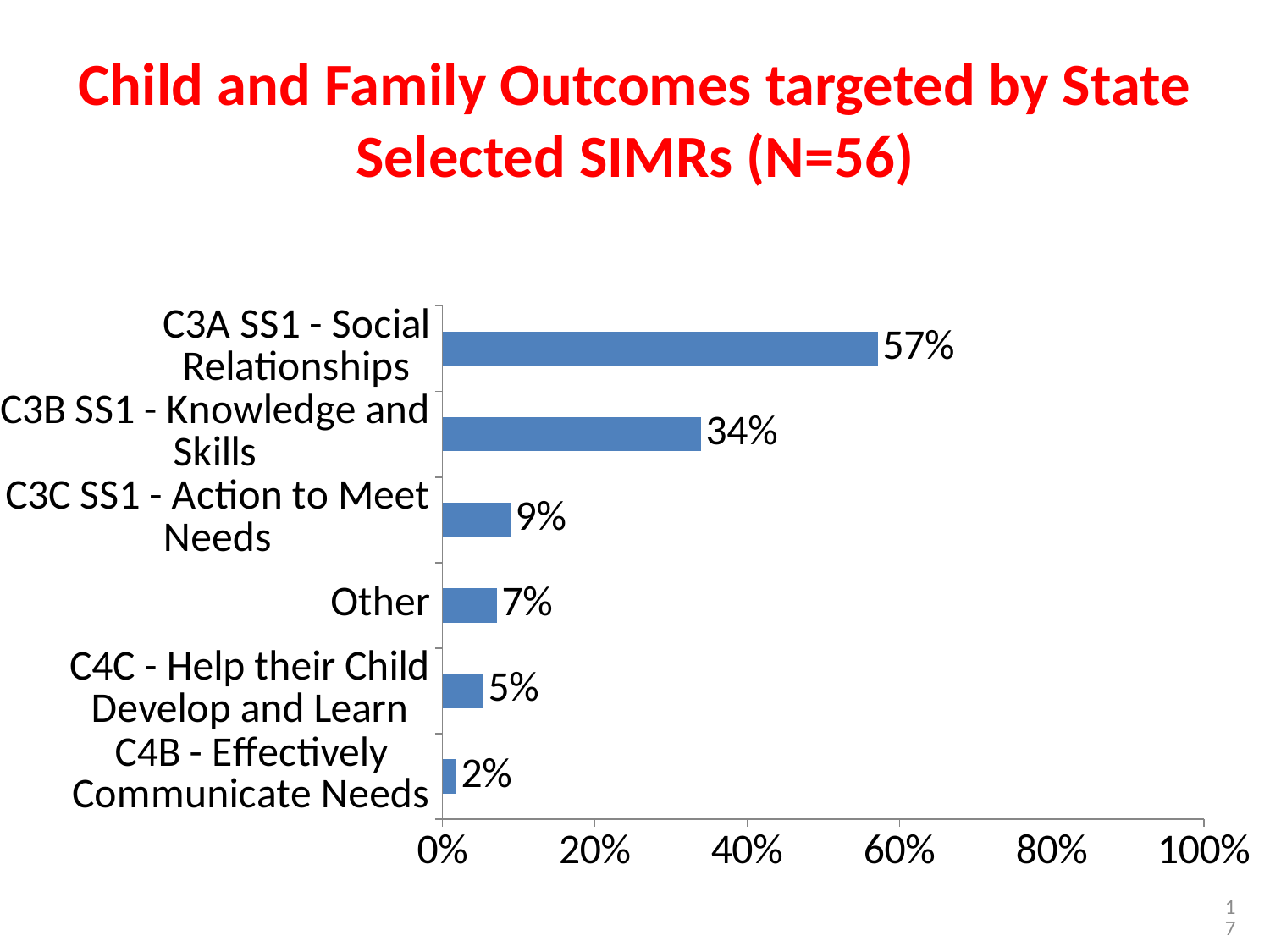
What is the title of the slide? Child and Family Outcomes targeted by State Selected SIMRs (N=56) What is the difference in percentage points between C3A SS1 - Social Relationships and C3B SS1 - Knowledge and Skills? 23 percentage points What percentage is shown for C4B - Effectively Communicate Needs? 2% What percentage is shown for the Other category? 7% What percentage is shown for C3A SS1 - Social Relationships? 57% Which is larger, the value for C3C SS1 - Action to Meet Needs or the value for C4C - Help their Child Develop and Learn? C3C SS1 - Action to Meet Needs Which category has the lowest percentage? C4B - Effectively Communicate Needs What percentage is shown for C3B SS1 - Knowledge and Skills? 34% Which category has the highest percentage? C3A SS1 - Social Relationships Is the value for C3B SS1 - Knowledge and Skills greater or less than 40%? less How many categories are shown in the chart? 6 What kind of chart is shown on the slide? Bar chart